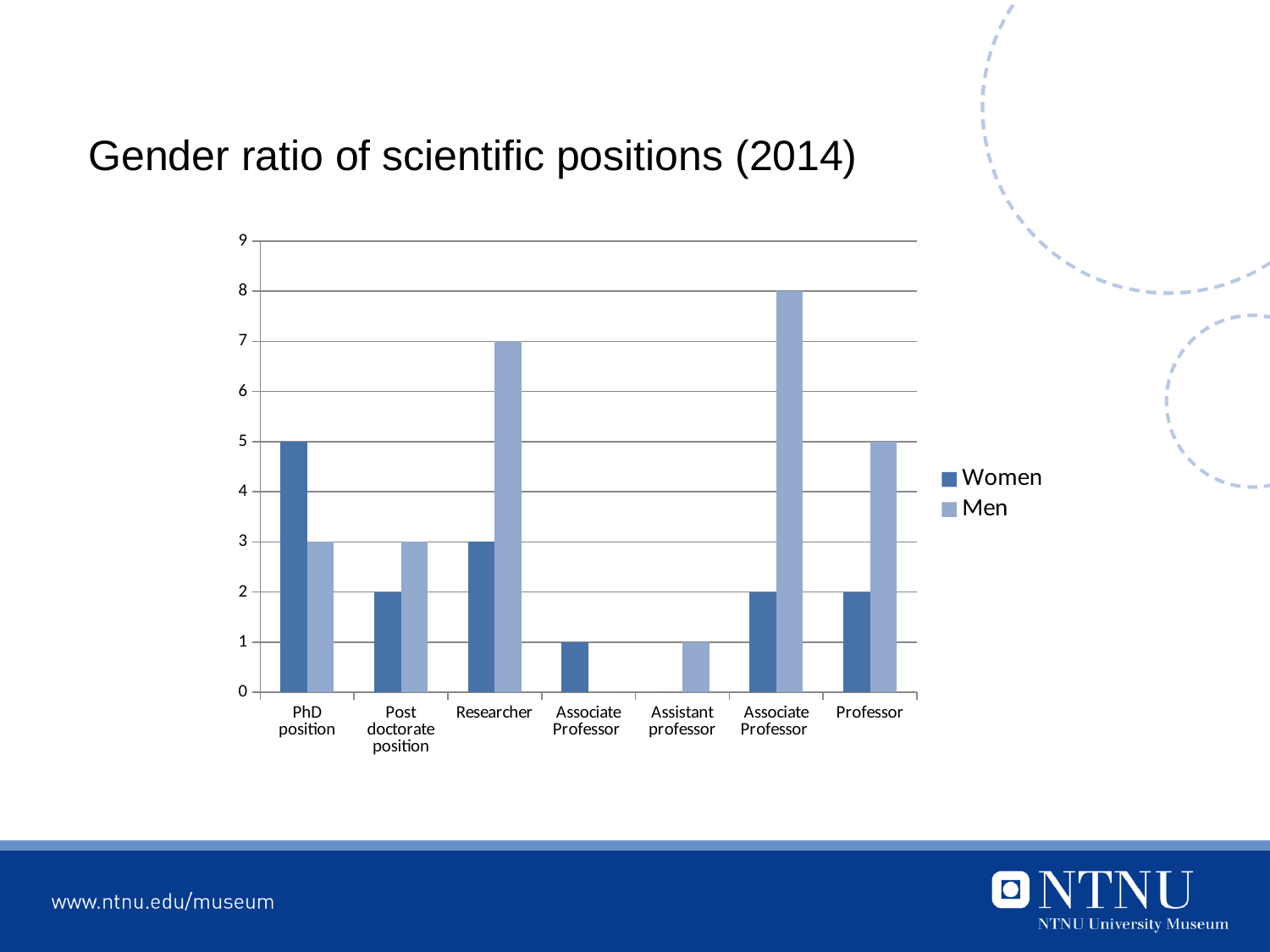
What is the value for Men in the Professor category? 5 What is the difference between Men and Women in the Researcher category? 4 How many series does the legend list? 2 In the PhD position category, which is larger, Women or Men? Women Which category has the highest value for Women? PhD position What is the value for Women in the Post doctorate position category? 2 How many position categories are shown on the x axis? 7 Is the value for Men in the Researcher category greater or less than 5? greater What type of chart is shown on the slide? bar chart What is the value for Men in the Researcher category? 7 What is the title of the chart? Gender ratio of scientific positions (2014) What is the value for Women in the PhD position category? 5